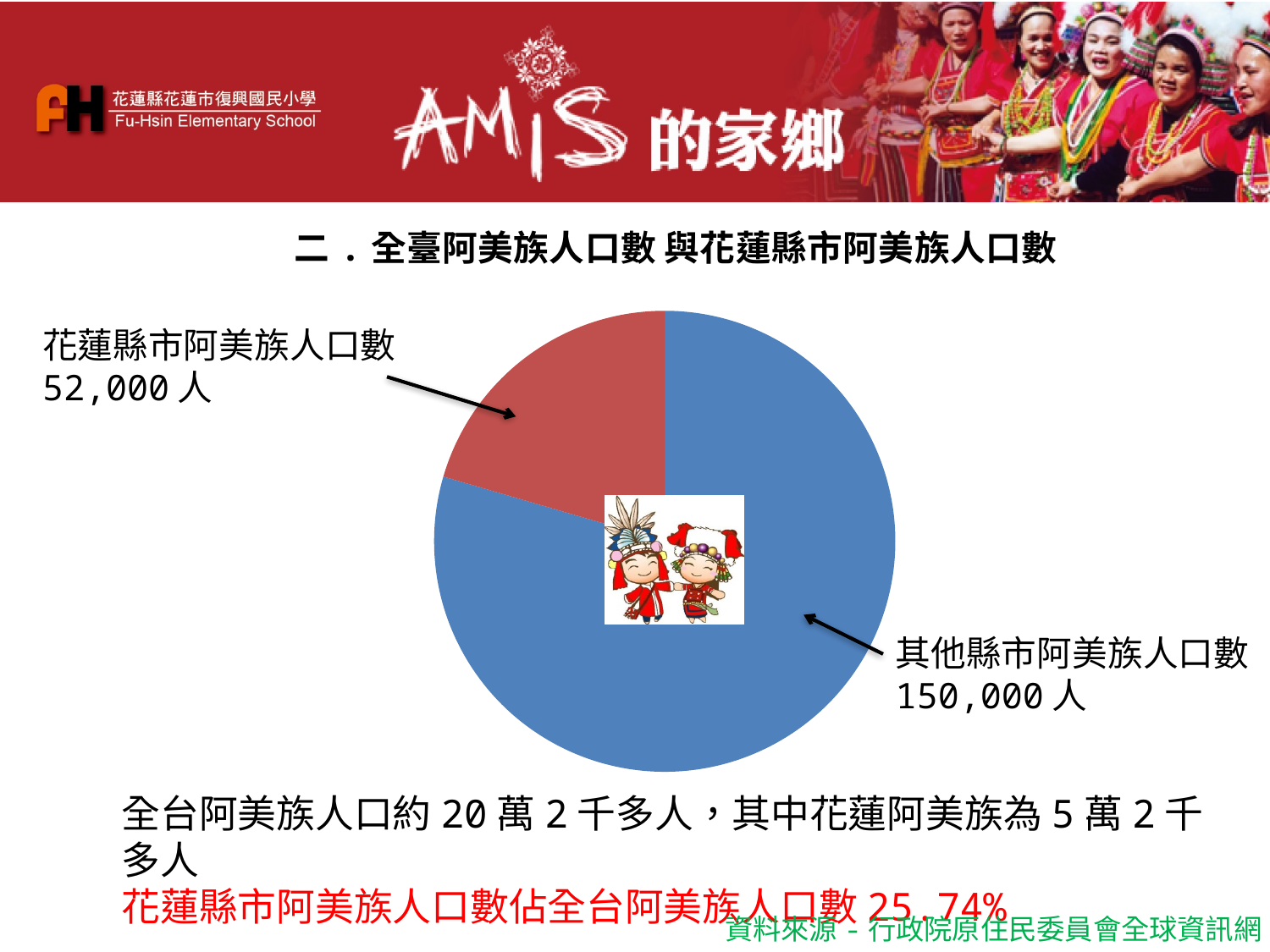
Which is larger, 花蓮縣市阿美族人口數 or 其他縣市阿美族人口數? 其他縣市阿美族人口數 Which slice of the pie chart is the largest? 其他縣市阿美族人口數 What share of the total does 花蓮縣市阿美族人口數 represent, as stated on the slide? 25.74% What kind of chart is shown on the slide? pie chart What is the total of the two values shown in the pie chart? 202,000 人 What is the value shown for 花蓮縣市阿美族人口數? 52,000 人 What is the value shown for 其他縣市阿美族人口數? 150,000 人 What colour is the slice for 其他縣市阿美族人口數? blue What is the difference between 其他縣市阿美族人口數 and 花蓮縣市阿美族人口數? 98,000 人 Which slice of the pie chart is the smallest? 花蓮縣市阿美族人口數 What colour is the slice for 花蓮縣市阿美族人口數? red How many slices does the pie chart have? 2